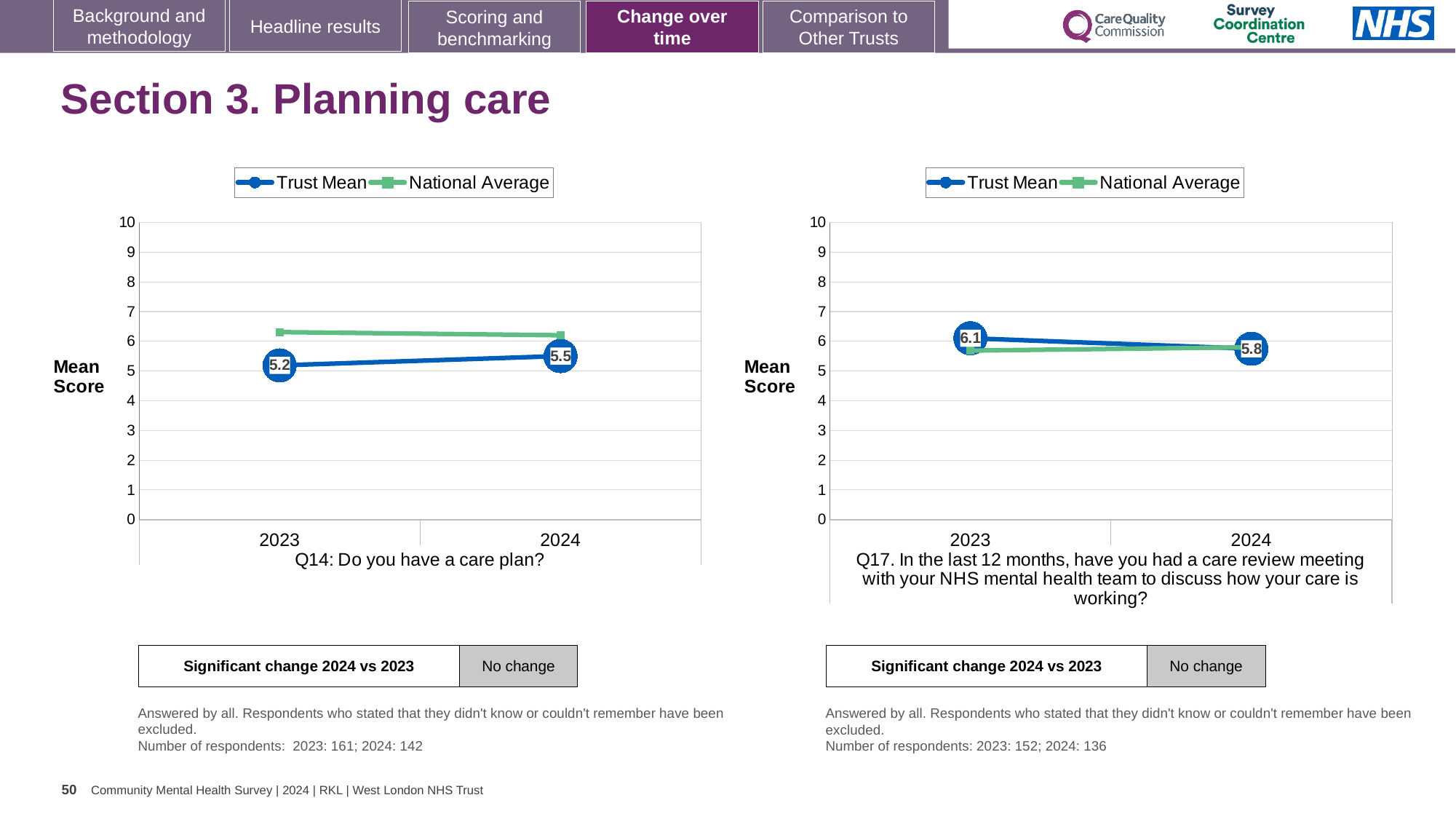
What kind of chart is the Q14 chart (left)? line chart In the Q14 chart (left), what is the Trust Mean score for 2023? 5.2 In the Q17 chart (right), what is the Trust Mean score for 2024? 5.8 In the Q17 chart (right), does the Trust Mean rise or fall from 2023 to 2024? fall In the Q17 chart (right), what is the Trust Mean score for 2023? 6.1 How many series does the legend of the Q17 chart (right) list? 2 In the Q14 chart (left), does the Trust Mean rise or fall from 2023 to 2024? rise In the Q14 chart (left), what is the Trust Mean score for 2024? 5.5 What is the y-axis label on the Q17 chart (right)? Mean Score In the Q14 chart (left), is the National Average value for 2023 greater or less than 6? greater In the Q14 chart (left), which is higher in 2023, the Trust Mean or the National Average? National Average In the Q14 chart (left), by how much did the Trust Mean change from 2023 to 2024? 0.3